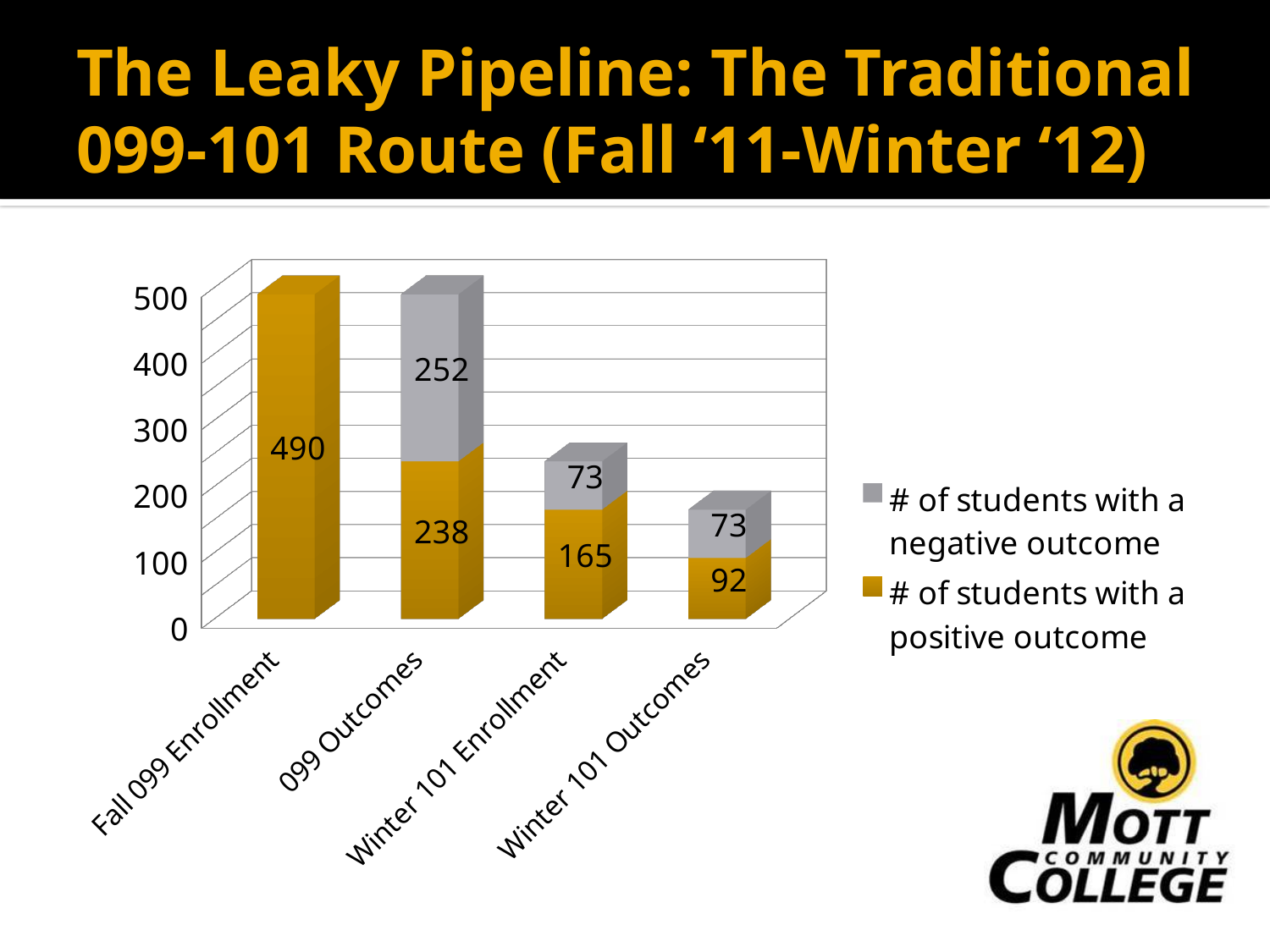
What is the difference between the number of students with a negative outcome and the number with a positive outcome for 099 Outcomes? 14 What is the total of the stacked bar for Winter 101 Enrollment? 238 Which colour represents the number of students with a negative outcome in the chart? Grey How many series does the chart's legend list? 2 What is the total of the stacked bar for 099 Outcomes? 490 What kind of chart is shown on the slide? Stacked bar chart What is the number of students with a positive outcome for Winter 101 Outcomes? 92 What is the number of students with a positive outcome for Winter 101 Enrollment? 165 Which category has the lowest number of students with a positive outcome? Winter 101 Outcomes What is the number of students with a negative outcome for 099 Outcomes? 252 What is the number of students with a positive outcome for Fall 099 Enrollment? 490 How many categories are shown on the x axis of the chart? 4